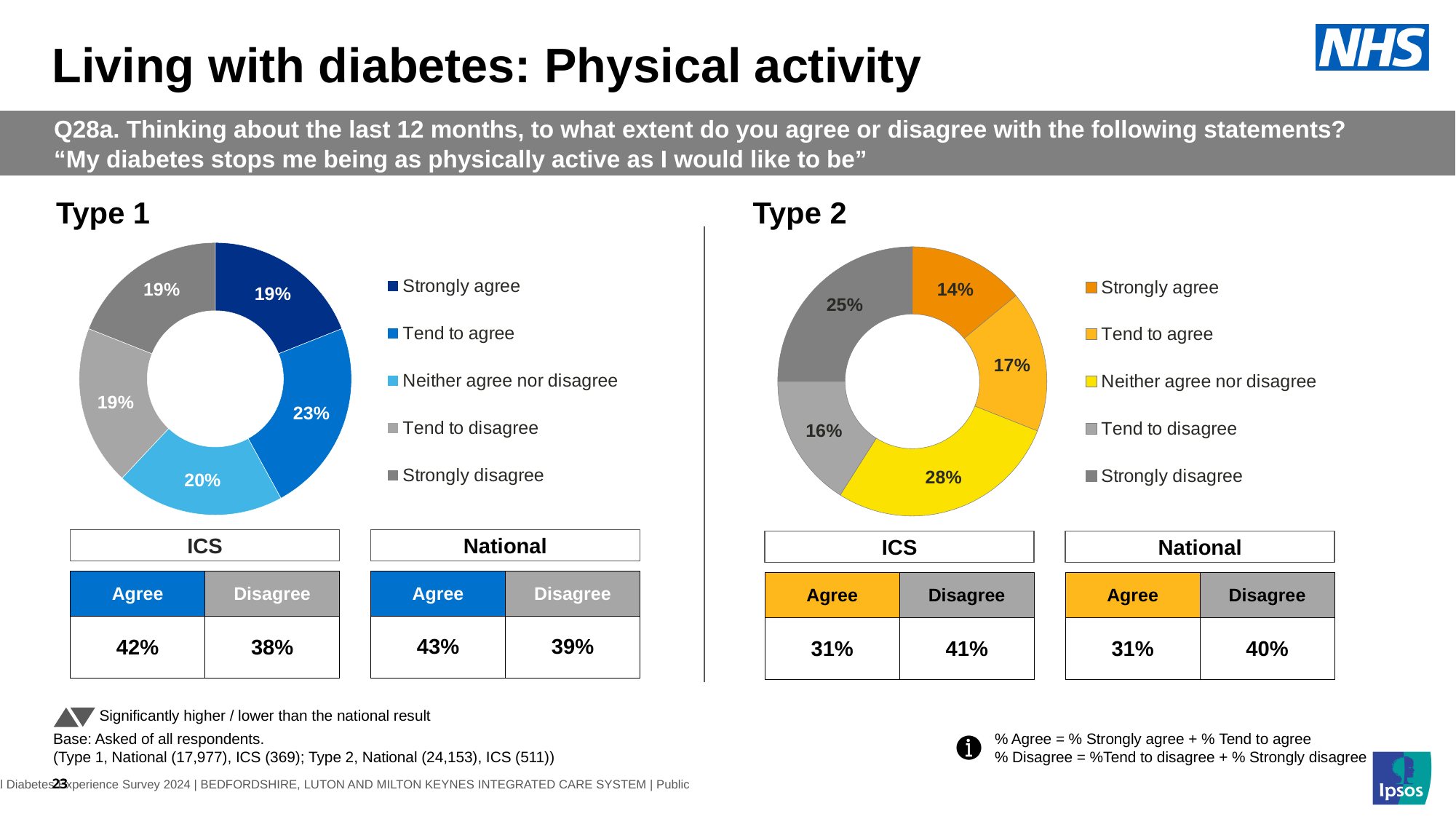
In the Type 2 chart, which response category has the smallest share? Strongly agree In the Type 1 chart, which is larger: the Tend to agree share or the Neither agree nor disagree share? Tend to agree In the Type 2 chart, which response category has the largest share? Neither agree nor disagree In the Type 1 chart, what is the combined share of Strongly agree and Tend to agree? 42% In the Type 1 chart, what percentage of respondents said they tend to agree? 23% In the Type 2 chart, what percentage of respondents said they neither agree nor disagree? 28% What kind of chart is used for Type 2? Donut (pie) chart In the Type 2 chart, what percentage of respondents strongly disagree? 25% In the Type 2 chart, what colour is the Neither agree nor disagree segment? Yellow In the Type 1 chart, which response category has the largest share? Tend to agree In the Type 2 chart, what is the difference between the Strongly disagree share and the Strongly agree share? 11 percentage points How many response categories does the legend of the Type 1 chart list? 5